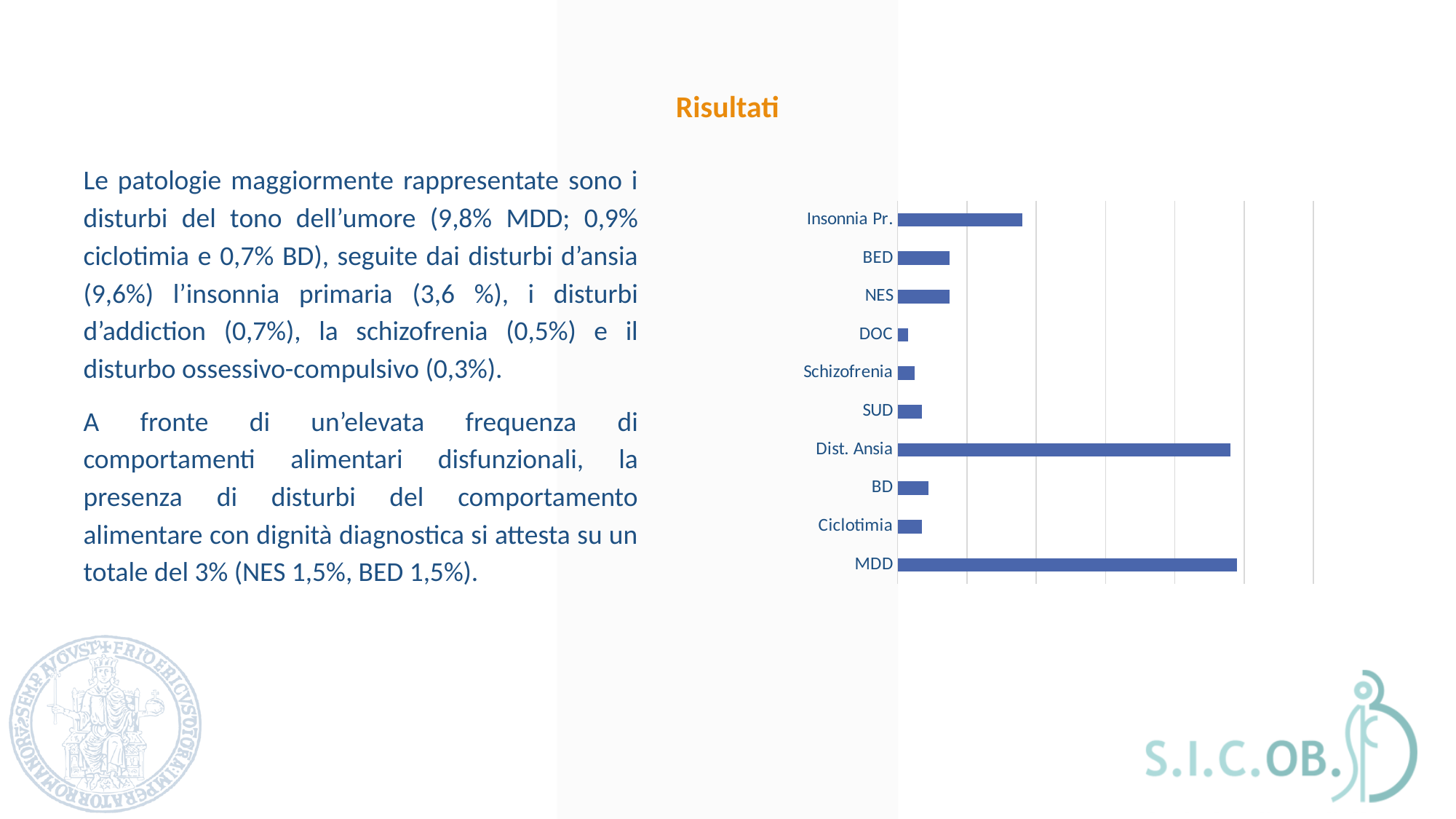
Which bar is longer, Dist. Ansia or SUD? Dist. Ansia Which category has the shortest bar in the chart? DOC What colour are the bars in the chart? blue Which bar is longer, Insonnia Pr. or BED? Insonnia Pr. Which bar is longer, NES or Ciclotimia? NES How many categories are plotted in the bar chart? 10 Are the bars in the chart drawn horizontally or vertically? horizontally What kind of chart is shown on the slide? bar chart